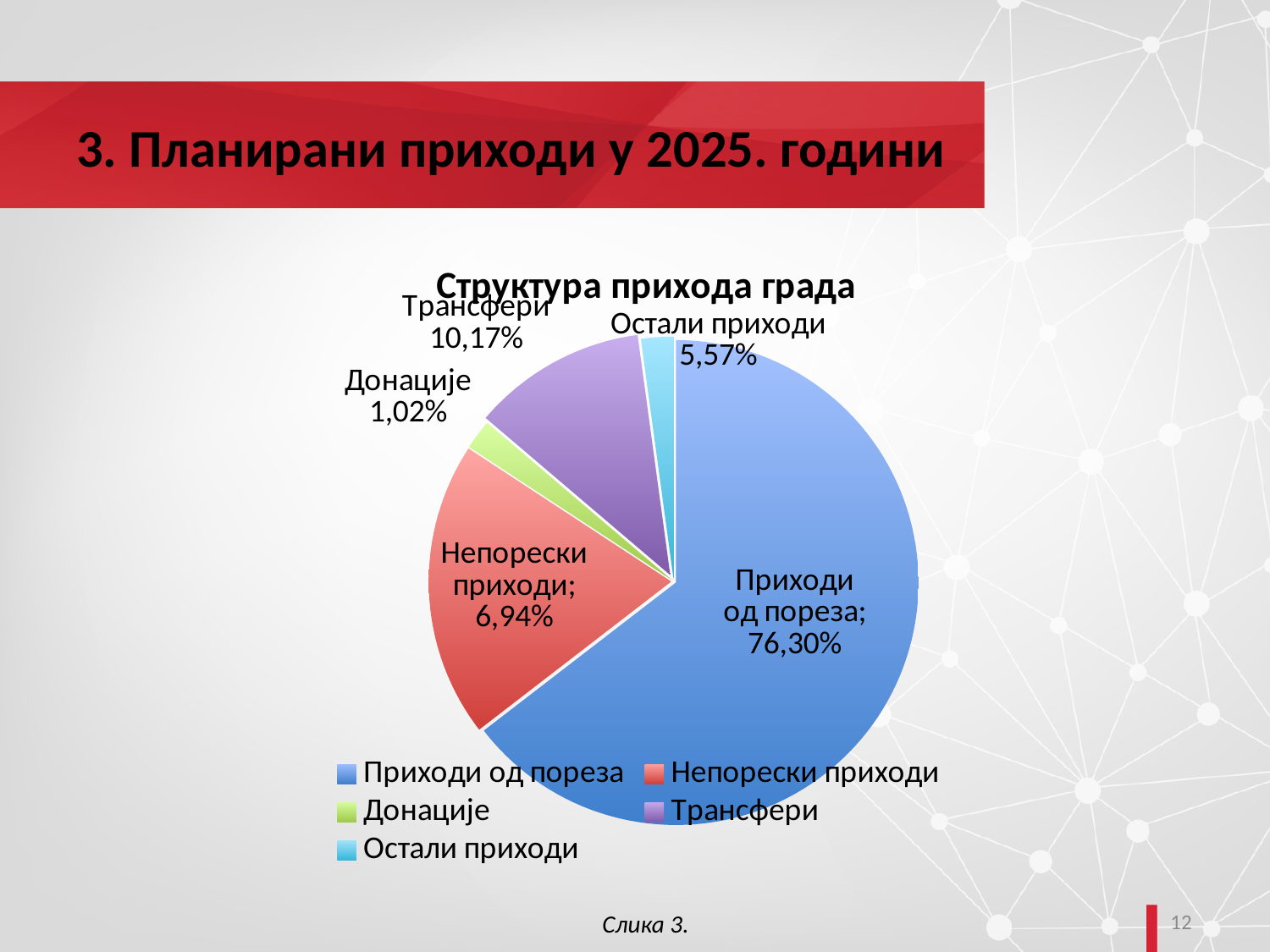
What is the value shown for Донације? 1,02% Which category has the largest slice of the pie? Приходи од пореза What is the difference between the shares of Приходи од пореза and Трансфери? 66,13% What type of chart is shown on the slide? Pie chart What is the value shown for Остали приходи? 5,57% How many categories are shown in the pie chart? 5 Which is larger, the share of Непорески приходи or the share of Остали приходи? Непорески приходи Which category has the smallest slice of the pie? Донације What is the value shown for Непорески приходи? 6,94% What is the difference between the shares of Трансфери and Непорески приходи? 3,23% What is the value shown for Трансфери? 10,17% What share of the pie does Приходи од пореза represent? 76,30%